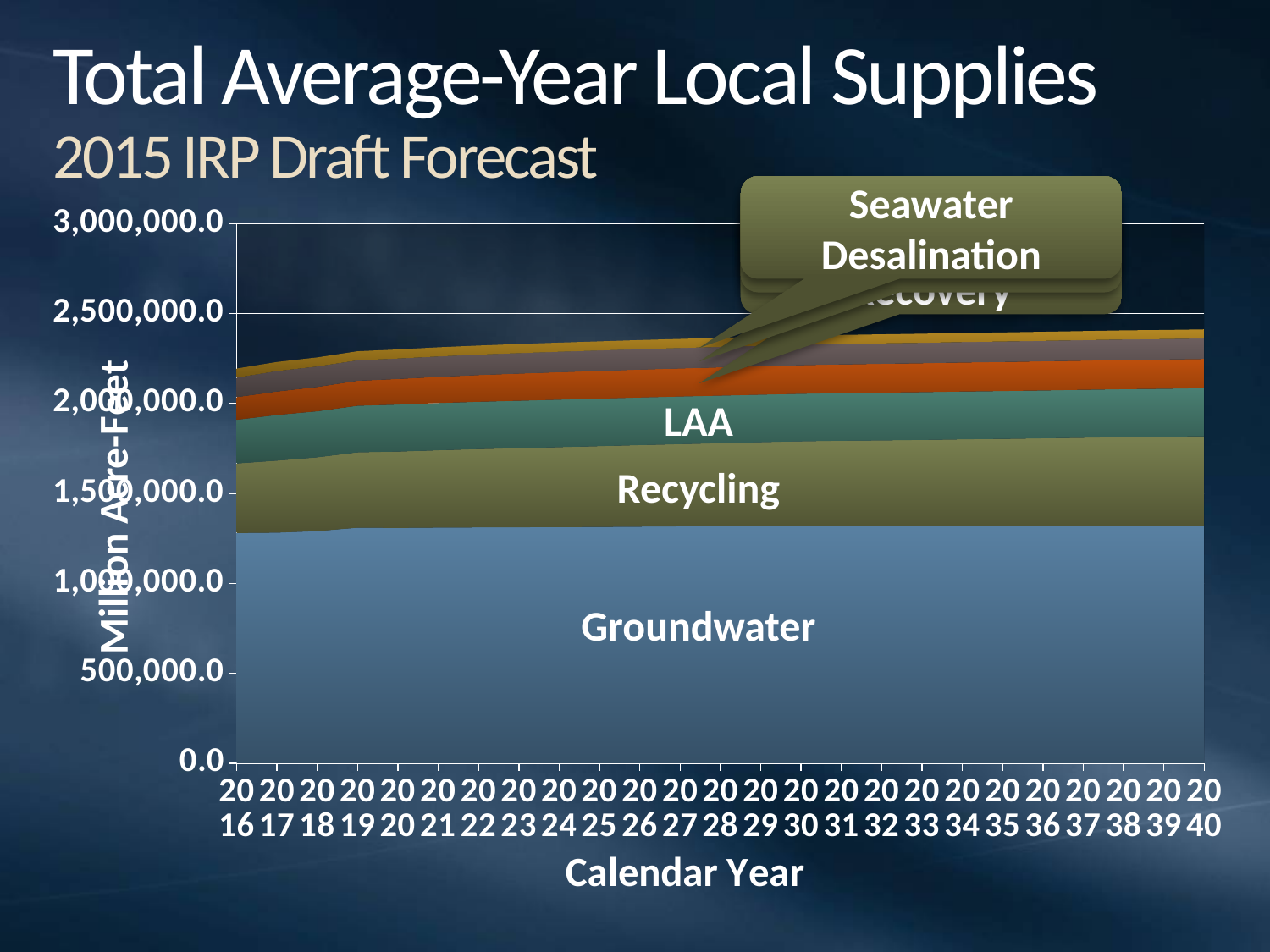
What is the last calendar year shown on the x axis? 2040 What kind of chart is shown on the slide? Stacked area chart Is the total local supply in 2016 greater or less than 2,000,000.0? greater Does the total local supply rise or fall from 2016 to 2040? rise What is the label of the x axis? Calendar Year What is the title of the chart on the slide? Total Average-Year Local Supplies 2015 IRP Draft Forecast Which supply category is plotted at the bottom of the stack? Groundwater Which supply category forms the largest layer of the stacked area? Groundwater Is the Groundwater supply in 2040 greater or less than 1,500,000.0? less How many calendar years are plotted along the x axis? 25 What is the first calendar year shown on the x axis? 2016 Is the total local supply in 2040 greater or less than 2,500,000.0? less